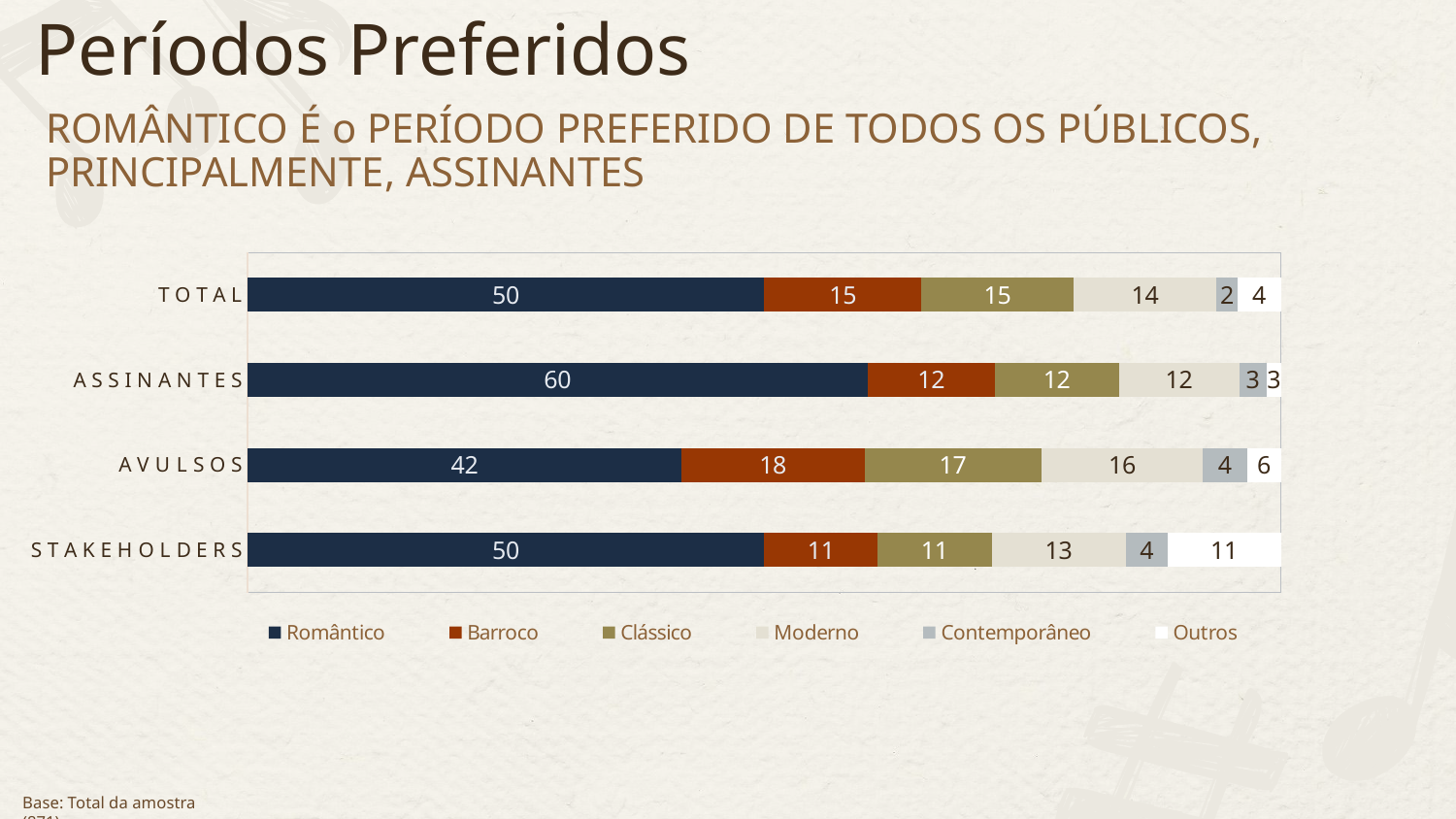
How many categories are shown on the chart? 4 How many series does the legend list? 6 What is the difference between the Romântico values for ASSINANTES and AVULSOS? 18 Which category has the lowest Romântico value? AVULSOS What is the Outros value for STAKEHOLDERS? 11 What is the Romântico value for ASSINANTES? 60 What is the total of the stacked bar for TOTAL? 100 What is the Moderno value for TOTAL? 14 Which is larger, the Clássico value for AVULSOS or the Clássico value for STAKEHOLDERS? AVULSOS What is the Barroco value for AVULSOS? 18 What kind of chart is shown on the slide? stacked bar chart Which category has the highest Romântico value? ASSINANTES